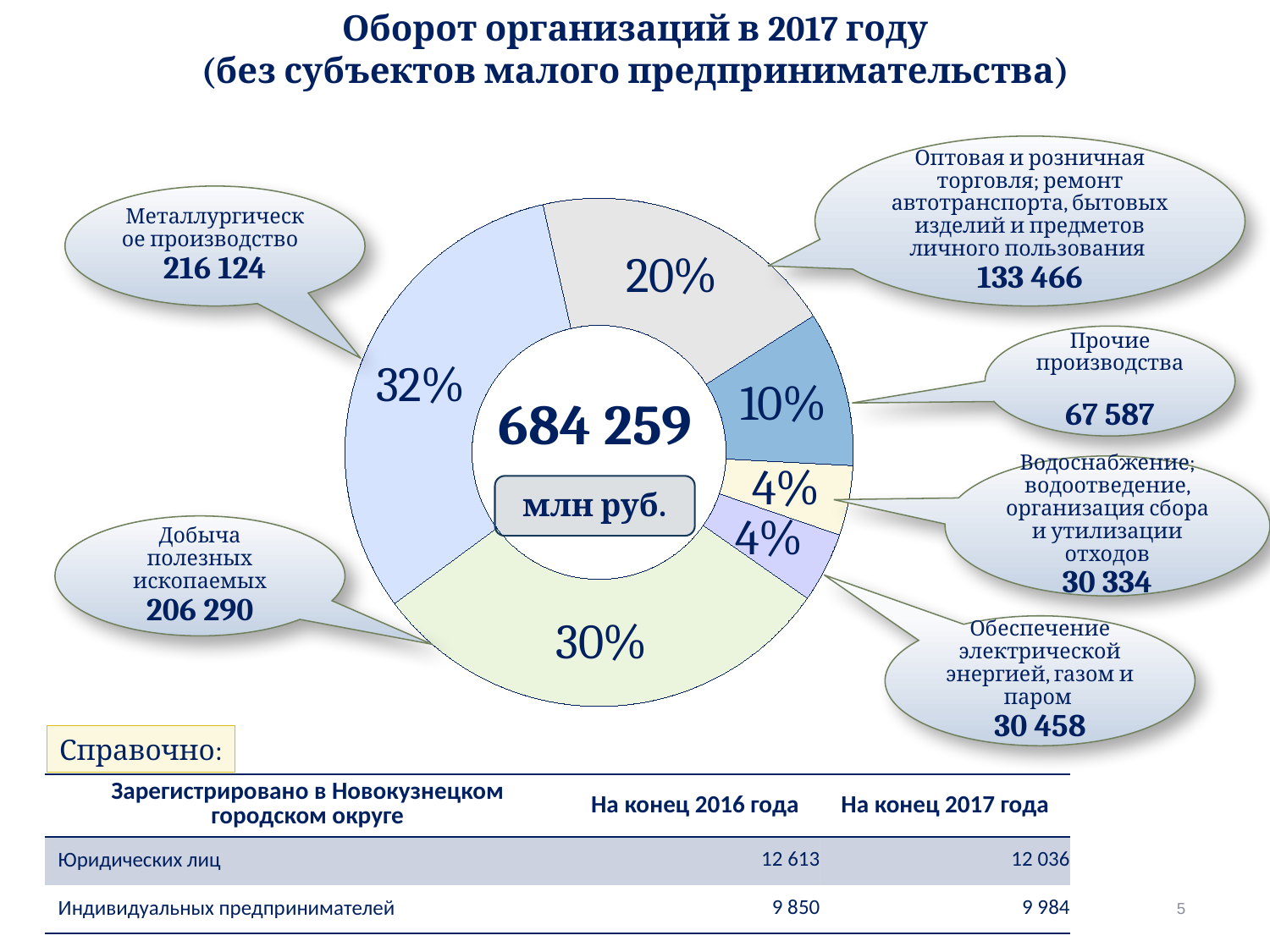
What is the turnover value for Добыча полезных ископаемых? 206 290 What kind of chart is shown on the slide? pie chart (donut) What share of the chart does Прочие производства account for? 10% What share of the chart does Оптовая и розничная торговля account for? 20% What is the total turnover shown in the centre of the chart? 684 259 млн руб. Which is larger: the value for Оптовая и розничная торговля or for Прочие производства? Оптовая и розничная торговля Which category has the largest share of the chart? Металлургическое производство What is the turnover value for Металлургическое производство? 216 124 What is the difference between the values for Металлургическое производство and Добыча полезных ископаемых? 9 834 What is the turnover value for Водоснабжение; водоотведение, организация сбора и утилизации отходов? 30 334 What is the title of the chart? Оборот организаций в 2017 году (без субъектов малого предпринимательства) How many categories are shown in the chart? 6